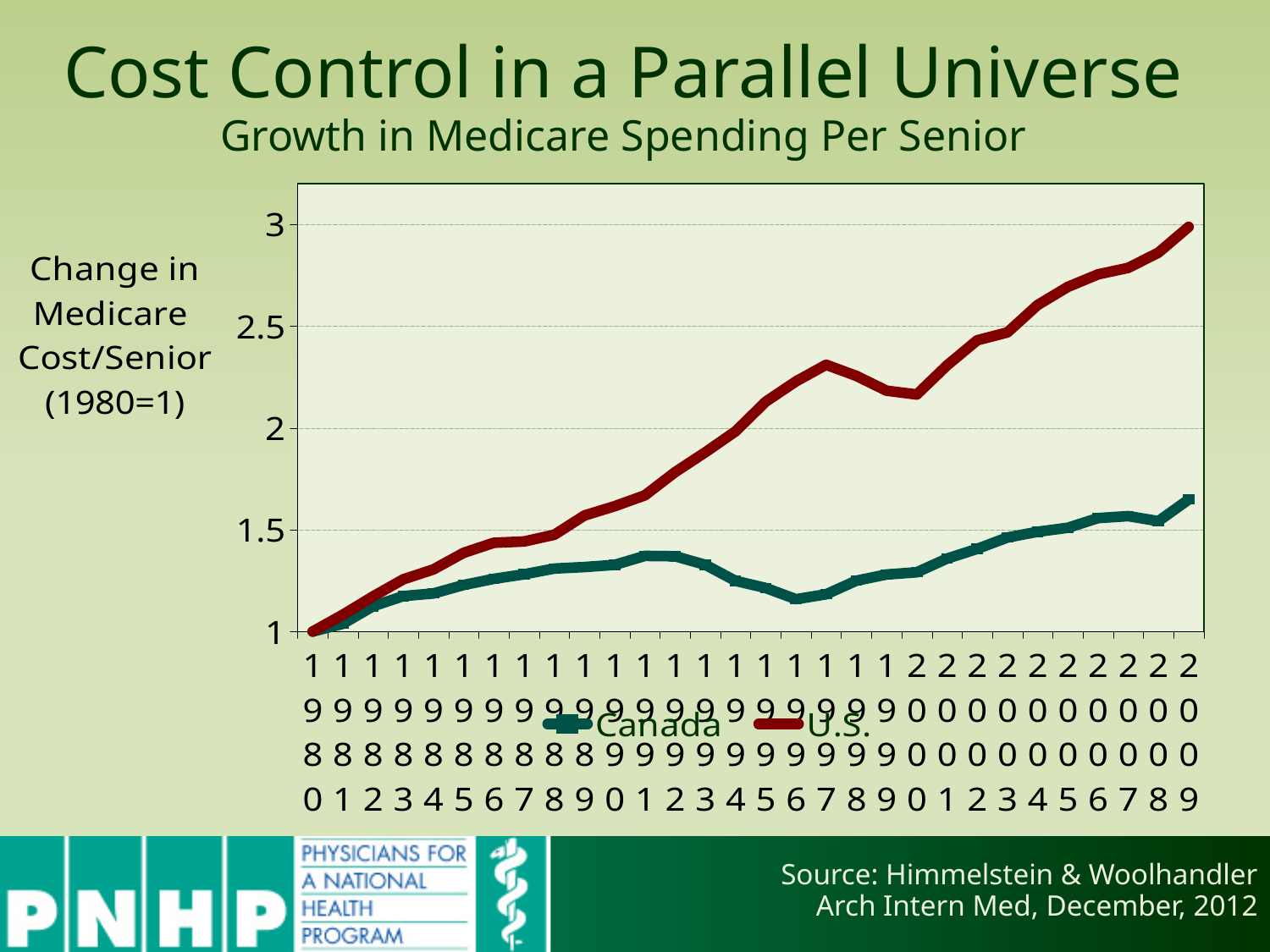
What is the value for both Canada and the U.S. in 1980? 1 Which two series are listed in the legend? Canada and U.S. Is the value for Canada in 2009 greater or less than 2? less Does the Canada line rise or fall between 1992 and 1996? fall How many series does the legend list? 2 Does the U.S. line generally rise or fall from 1980 to 2009? rise What is the first year shown on the x axis? 1980 What kind of chart is shown on the slide? line chart Which series has the higher value in 2009, Canada or the U.S.? U.S. Is the value for the U.S. in 2009 greater or less than 2.5? greater Is the value for Canada in 1996 greater or less than 1.5? less